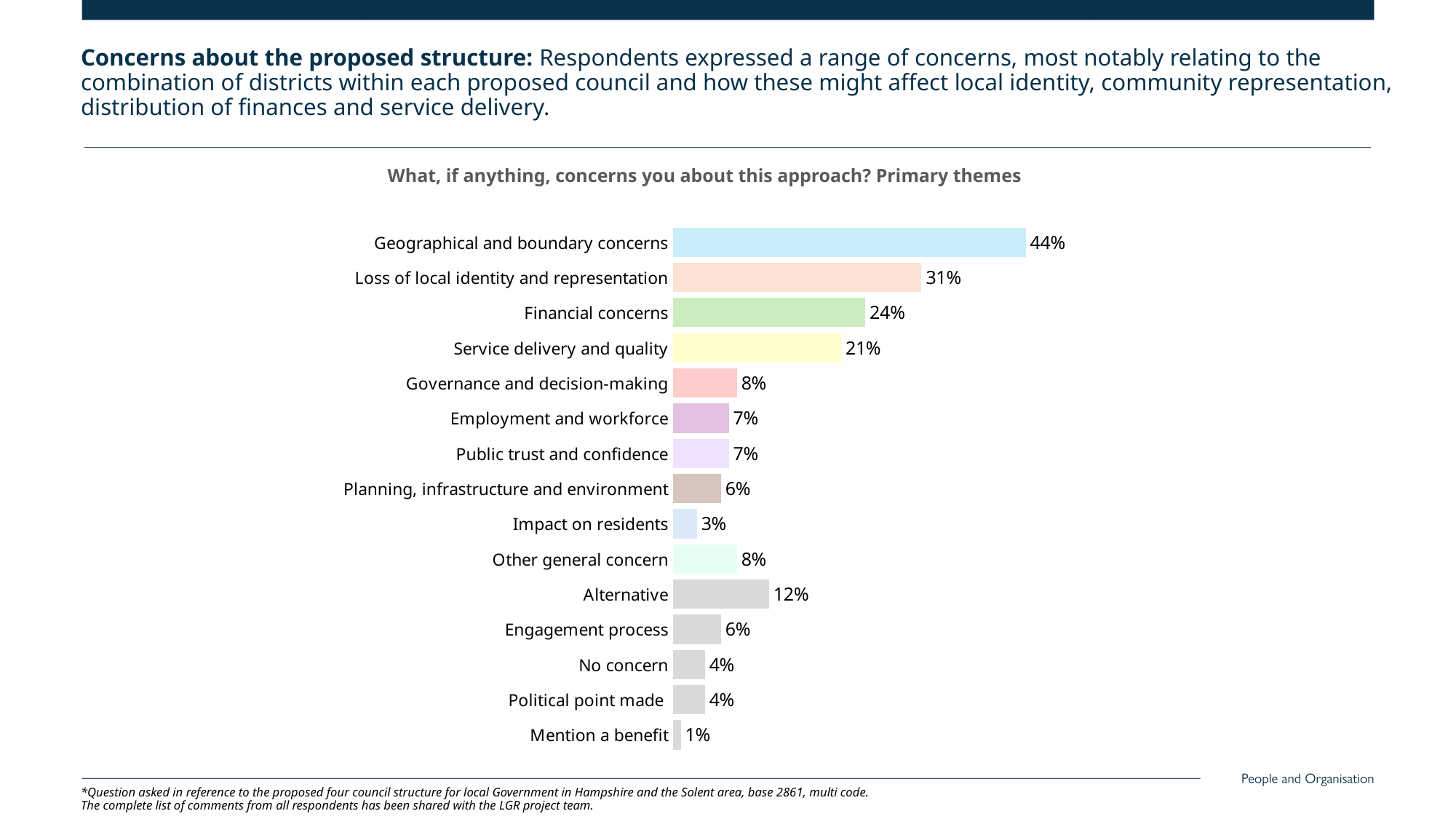
What is the difference between Loss of local identity and representation and Service delivery and quality? 10% Which is larger, Governance and decision-making or Impact on residents? Governance and decision-making What is the difference between Geographical and boundary concerns and Financial concerns? 20% What percentage is shown for Alternative? 12% What is the value for Financial concerns? 24% What kind of chart is shown on the slide? Bar chart Which theme has the highest percentage? Geographical and boundary concerns What is the title of the chart? What, if anything, concerns you about this approach? Primary themes What percentage of respondents raised geographical and boundary concerns? 44% How many themes are shown in the chart? 15 What is the value for No concern? 4% Which theme has the lowest percentage? Mention a benefit